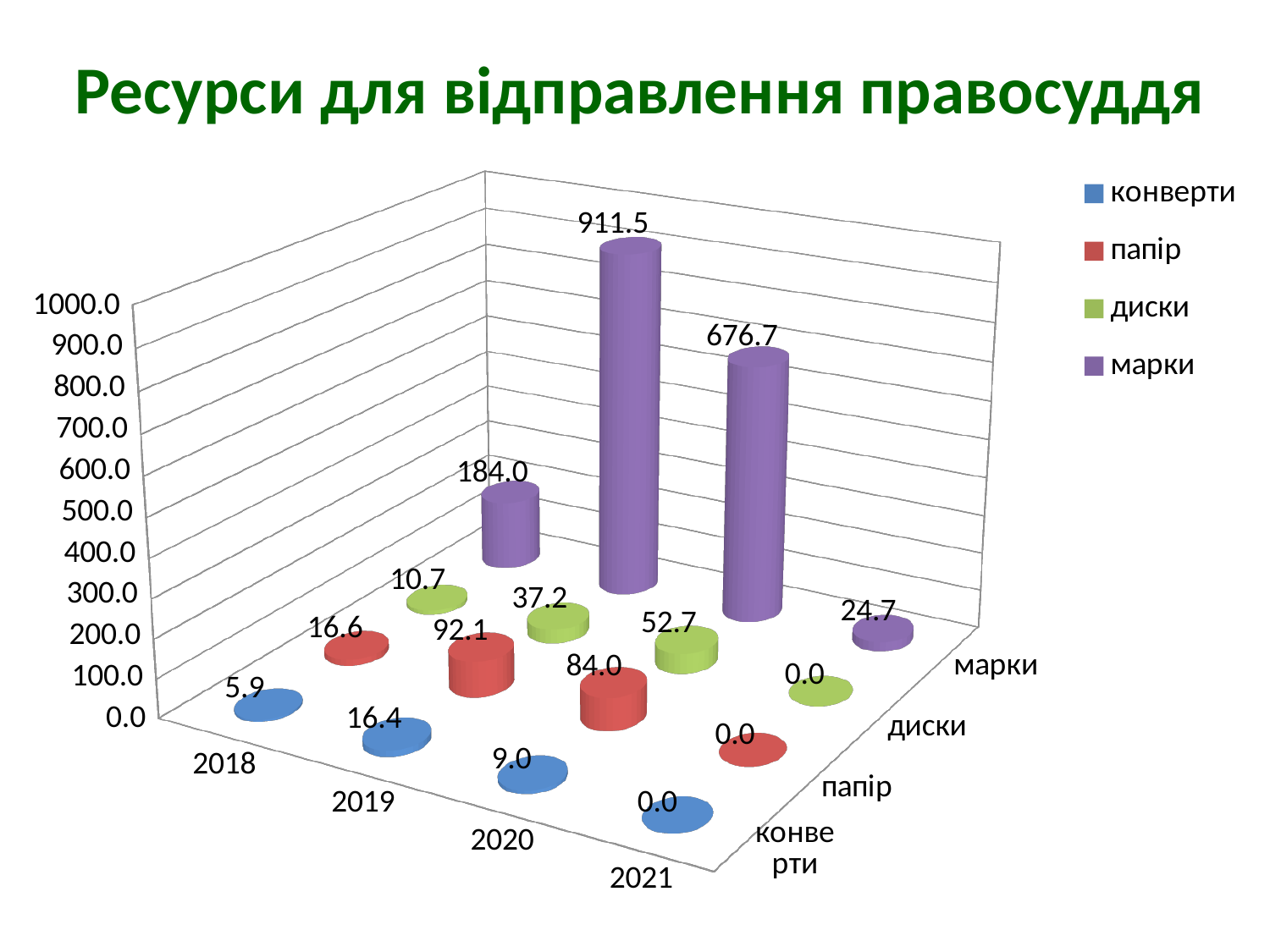
What is the value for марки in 2019? 911.5 In which year is the value for марки highest? 2019 Is the value for марки in 2020 greater or less than 600.0? greater How many years are shown on the x axis? 4 What is the value for конверти in 2019? 16.4 What is the difference between the марки values for 2019 and 2020? 234.8 How many series does the legend list? 4 What is the title of the chart? Ресурси для відправлення правосуддя What is the value for диски in 2020? 52.7 In which year is the value for папір lowest? 2021 What is the value for папір in 2020? 84.0 Which is larger, the папір value for 2019 or the папір value for 2020? 2019